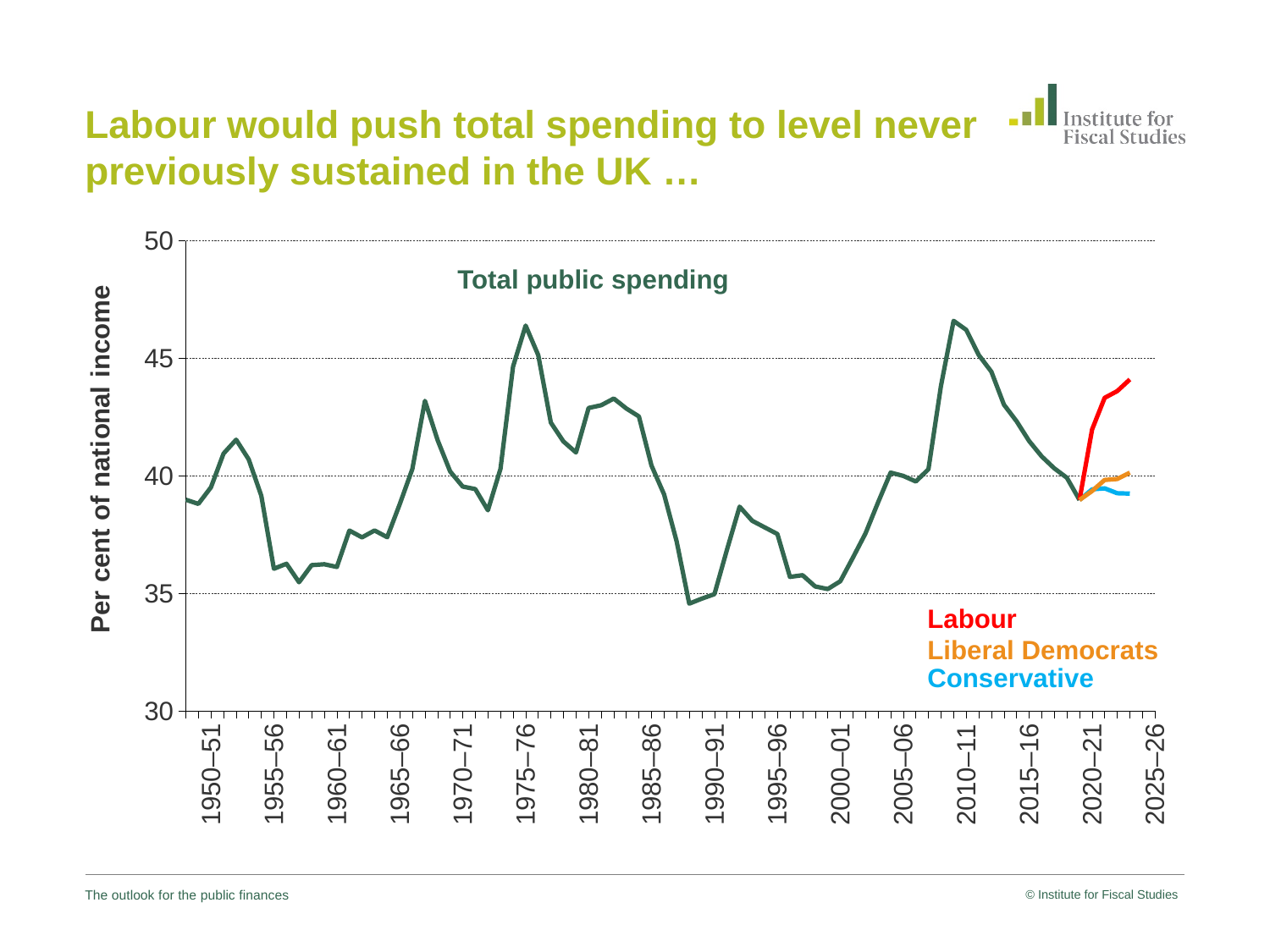
What colour is the Labour projection line? Red How many party projections does the legend list? 3 Is total public spending in 1990–91 greater or less than 40 per cent of national income? less Which party's projection reaches the highest level of total public spending by 2025–26? Labour Is total public spending in 1975–76 greater or less than 45 per cent of national income? greater What type of chart is shown on the slide? Line chart Does total public spending rise or fall between 2010–11 and 2015–16? Fall Is total public spending in 2010–11 greater or less than 45 per cent of national income? greater What is the label on the vertical axis? Per cent of national income Which party's projection is lower at the end of the chart, Labour or Conservative? Conservative